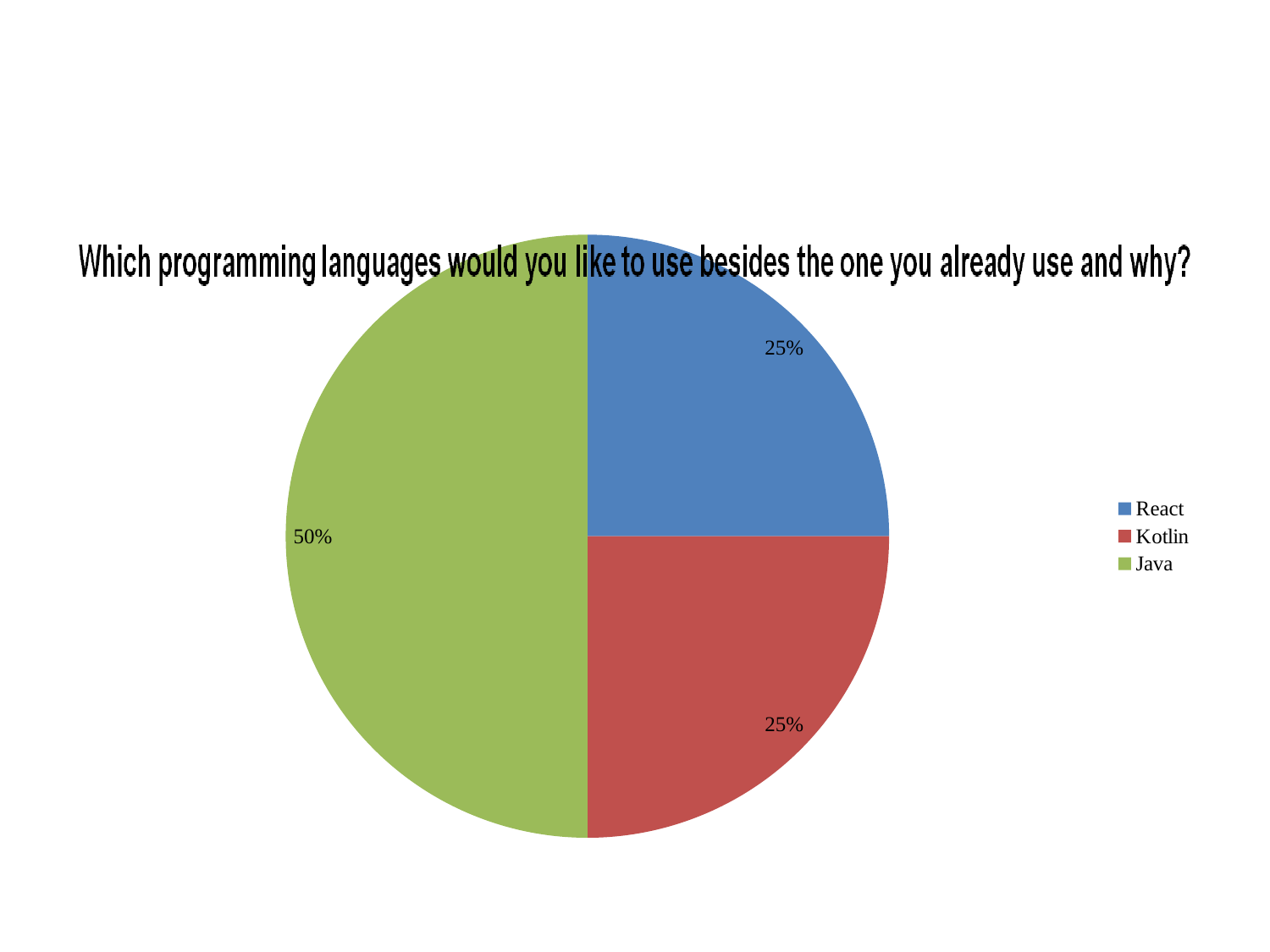
What is the difference between the Java share and the React share? 25% How many slices does the pie chart have? 3 What share of the pie does Kotlin have? 25% Which colour represents Kotlin in the pie chart? red What kind of chart is shown on the slide? pie chart What share of the pie does React have? 25% Which is larger, the Java slice or the Kotlin slice? Java Which language has the largest slice of the pie? Java What is the title of the chart? Which programming languages would you like to use besides the one you already use and why? What share of the pie does Java have? 50% How many entries does the legend list? 3 What is the combined share of React and Kotlin? 50%